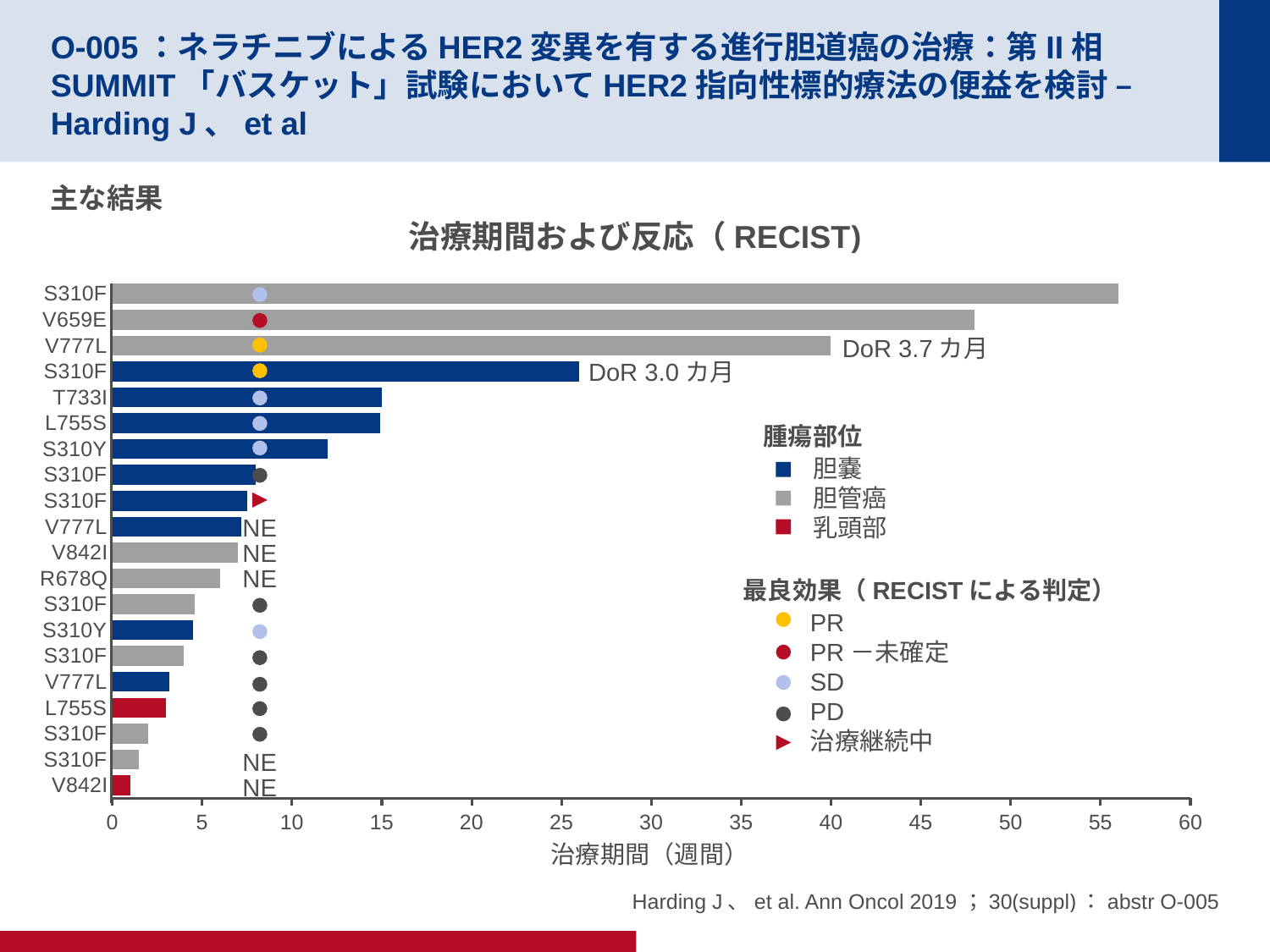
What is the label of the x axis? 治療期間（週間） Is the treatment duration for T733I greater or less than 10 weeks? greater What kind of chart is shown on the slide? Bar chart How many tumour sites (腫瘍部位) are listed in the legend? 3 Is the treatment duration for V659E greater or less than 50 weeks? less How many bars (patients) are plotted in the chart? 20 Is the treatment duration for R678Q greater or less than 10 weeks? less Which bar has the longest treatment duration? S310F (topmost bar) Which bar has the shortest treatment duration? V842I (bottom bar) What DoR value is annotated next to the V777L bar near the top of the chart? DoR 3.7 カ月 Which has the longer treatment duration, V659E or R678Q? V659E